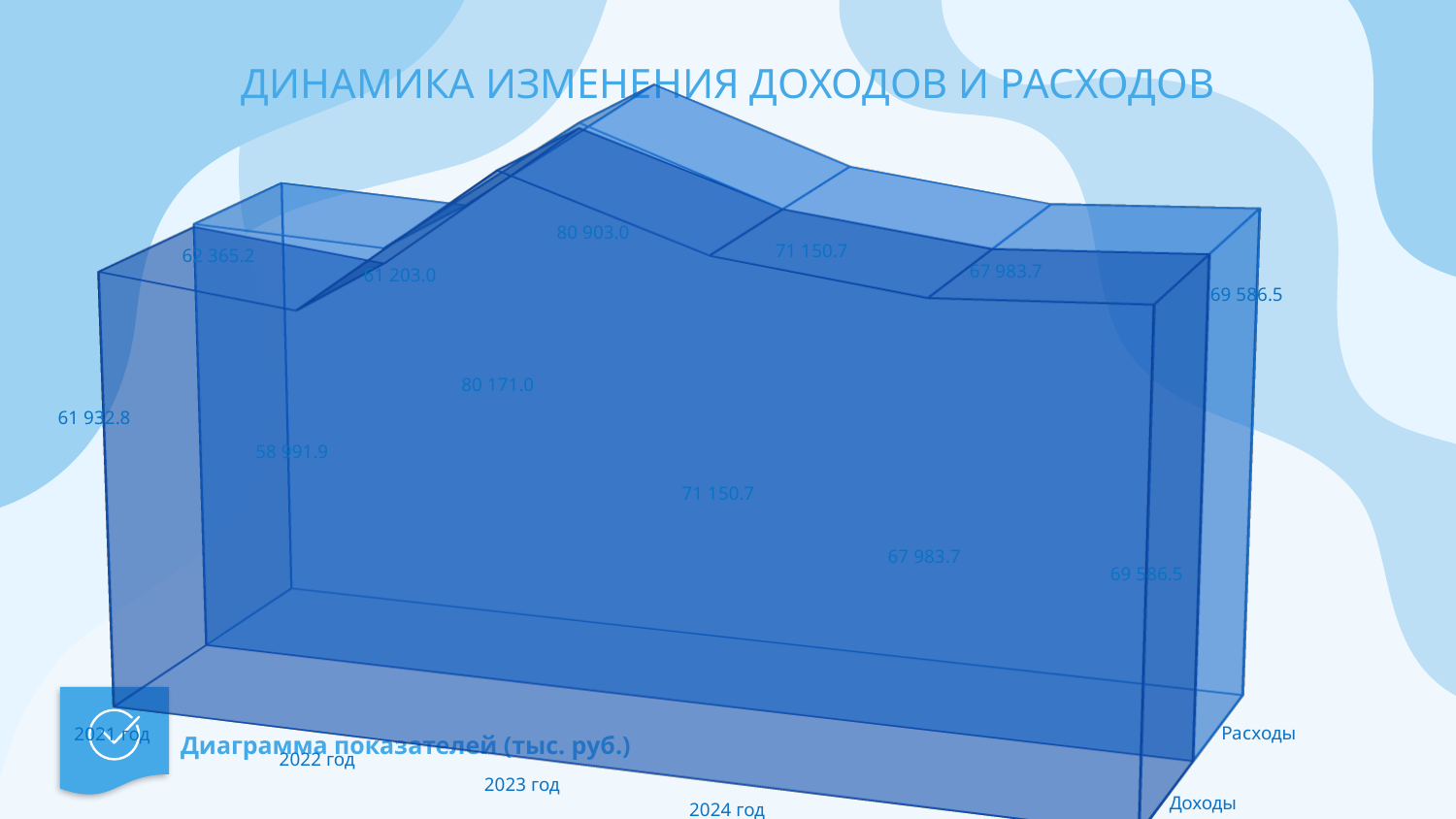
What is the value of Доходы for 2023 год? 80 171.0 What is the value of Доходы for 2022 год? 58 991.9 How many series does the chart show? 2 What is the value of Доходы for 2021 год? 61 932.8 What is the value of Расходы for 2021 год? 62 365.2 What is the value of Расходы for 2024 год? 71 150.7 Which is larger in 2022 год, Доходы or Расходы? Расходы In which year is Доходы lowest? 2022 год What is the value of Расходы for 2023 год? 80 903.0 What is the difference between Расходы and Доходы in 2021 год? 432.4 What kind of chart is shown on the slide? Area chart In which year is Доходы highest? 2023 год